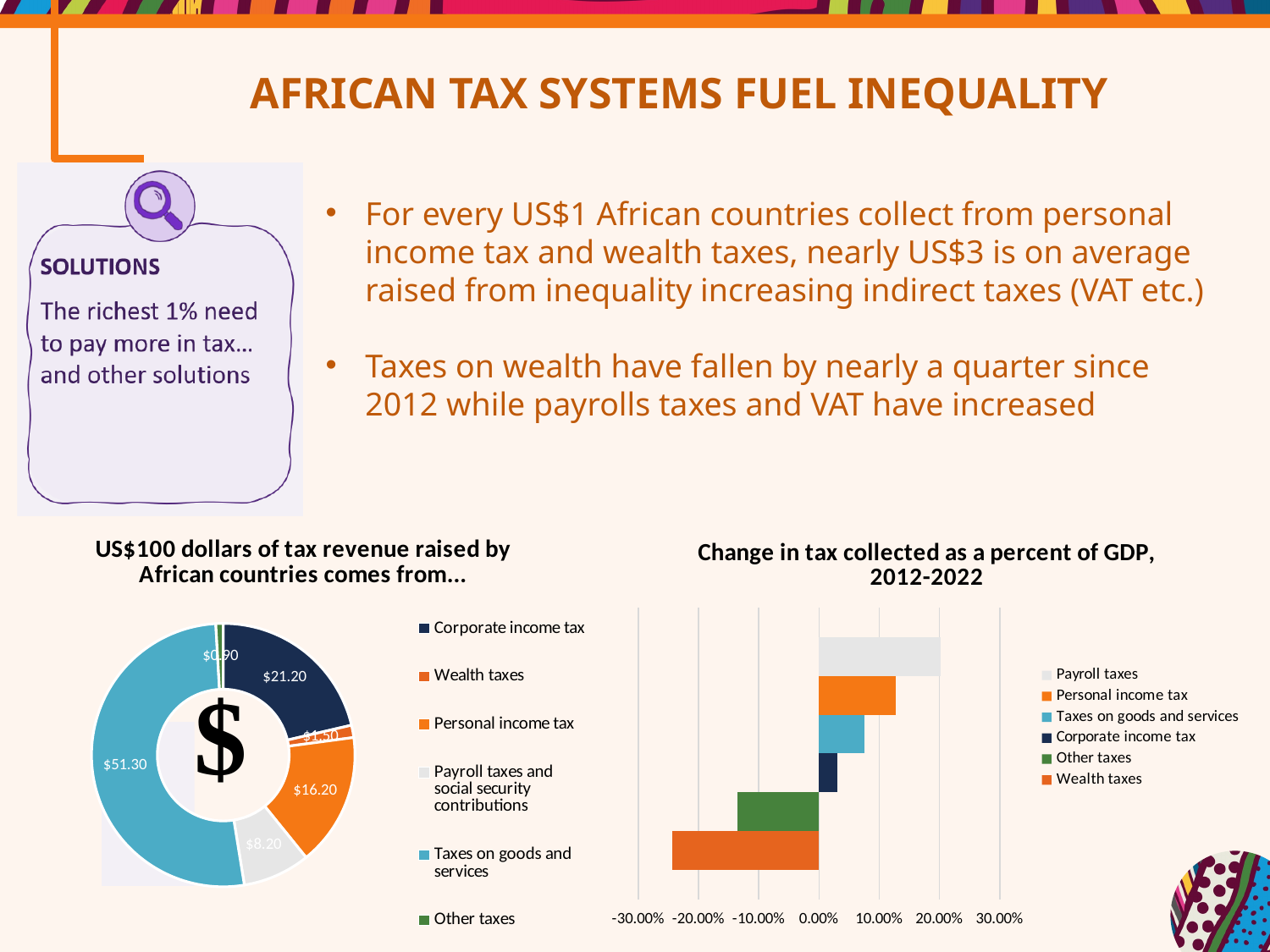
In the chart 'US$100 dollars of tax revenue raised by African countries comes from...', what is the value for Payroll taxes and social security contributions? $8.20 In the chart 'Change in tax collected as a percent of GDP, 2012-2022', is the value for Wealth taxes greater or less than -10.00%? less How many series does the legend of the chart 'Change in tax collected as a percent of GDP, 2012-2022' list? 6 In the chart 'US$100 dollars of tax revenue raised by African countries comes from...', what is the value for Taxes on goods and services? $51.30 In the chart 'Change in tax collected as a percent of GDP, 2012-2022', is the value for Payroll taxes greater or less than 10.00%? greater In the chart 'US$100 dollars of tax revenue raised by African countries comes from...', which category has the largest value? Taxes on goods and services What kind of chart is 'Change in tax collected as a percent of GDP, 2012-2022'? bar chart How many categories does the legend of the chart 'US$100 dollars of tax revenue raised by African countries comes from...' list? 6 In the chart 'US$100 dollars of tax revenue raised by African countries comes from...', what is the difference between Corporate income tax and Personal income tax? $5.00 In the chart 'US$100 dollars of tax revenue raised by African countries comes from...', what is the value for Personal income tax? $16.20 In the chart 'US$100 dollars of tax revenue raised by African countries comes from...', which is larger, Corporate income tax or Personal income tax? Corporate income tax In the chart 'US$100 dollars of tax revenue raised by African countries comes from...', what is the value for Corporate income tax? $21.20